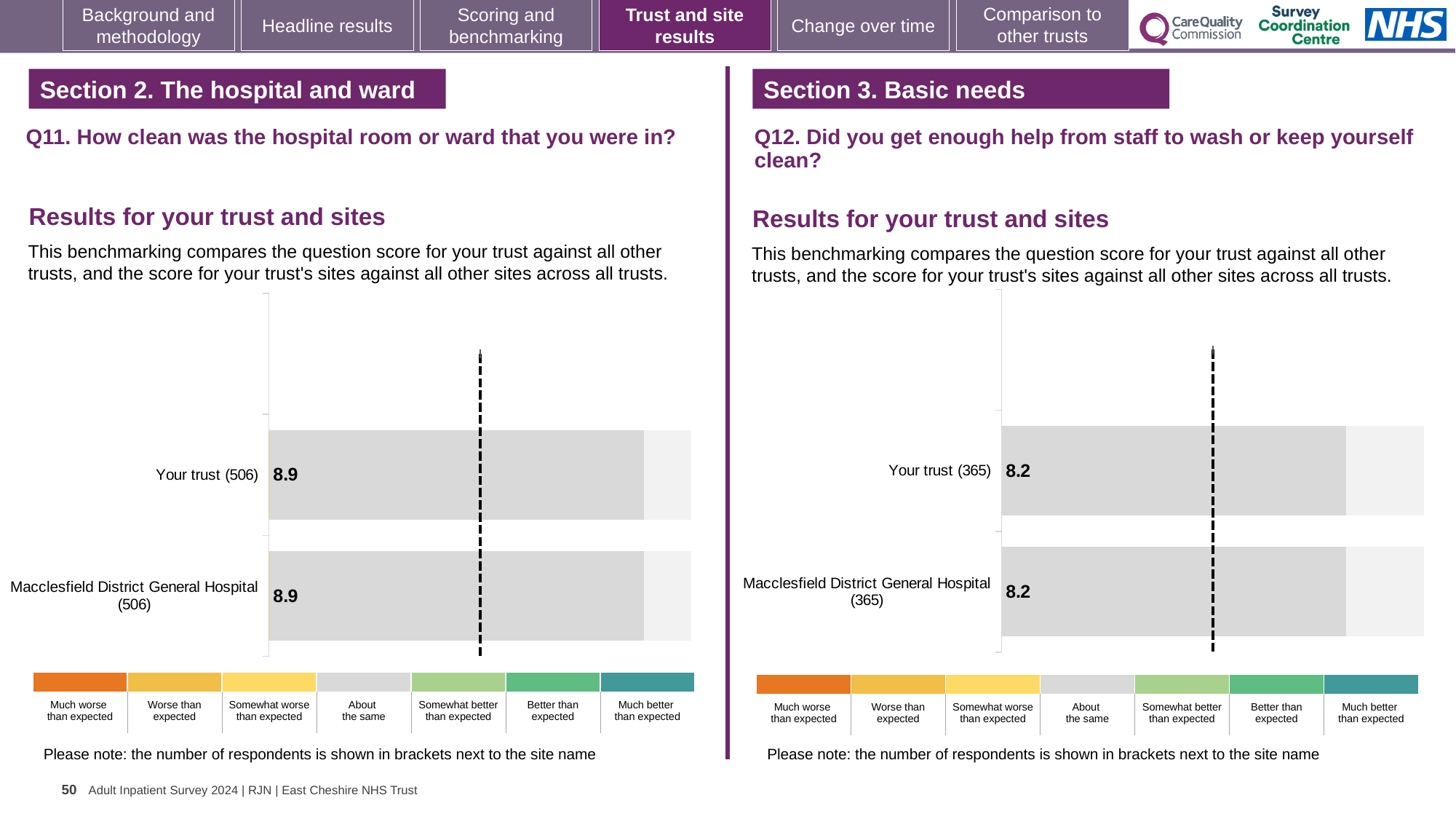
In the Q12 chart on the right, what is the score for Your trust? 8.2 What kind of chart is used for the Q11 results on the left? Bar chart In the Q12 chart on the right, how many respondents are shown in brackets for Macclesfield District General Hospital? 365 In the Q12 chart on the right, what is the difference between the score for Your trust and the score for Macclesfield District General Hospital? 0 In the Q12 chart on the right, what is the score for Macclesfield District General Hospital? 8.2 In the Q11 chart on the left, what is the score for Macclesfield District General Hospital? 8.9 In the Q11 chart on the left, how many respondents are shown in brackets for Your trust? 506 Is the score for Your trust in the Q12 chart on the right greater or less than the score for Your trust in the Q11 chart on the left? less How many bars are plotted in the Q11 chart on the left? 2 In the Q11 chart on the left, what is the score for Your trust? 8.9 In the Q11 chart on the left, what is the difference between the score for Your trust and the score for Macclesfield District General Hospital? 0 How many bars are plotted in the Q12 chart on the right? 2